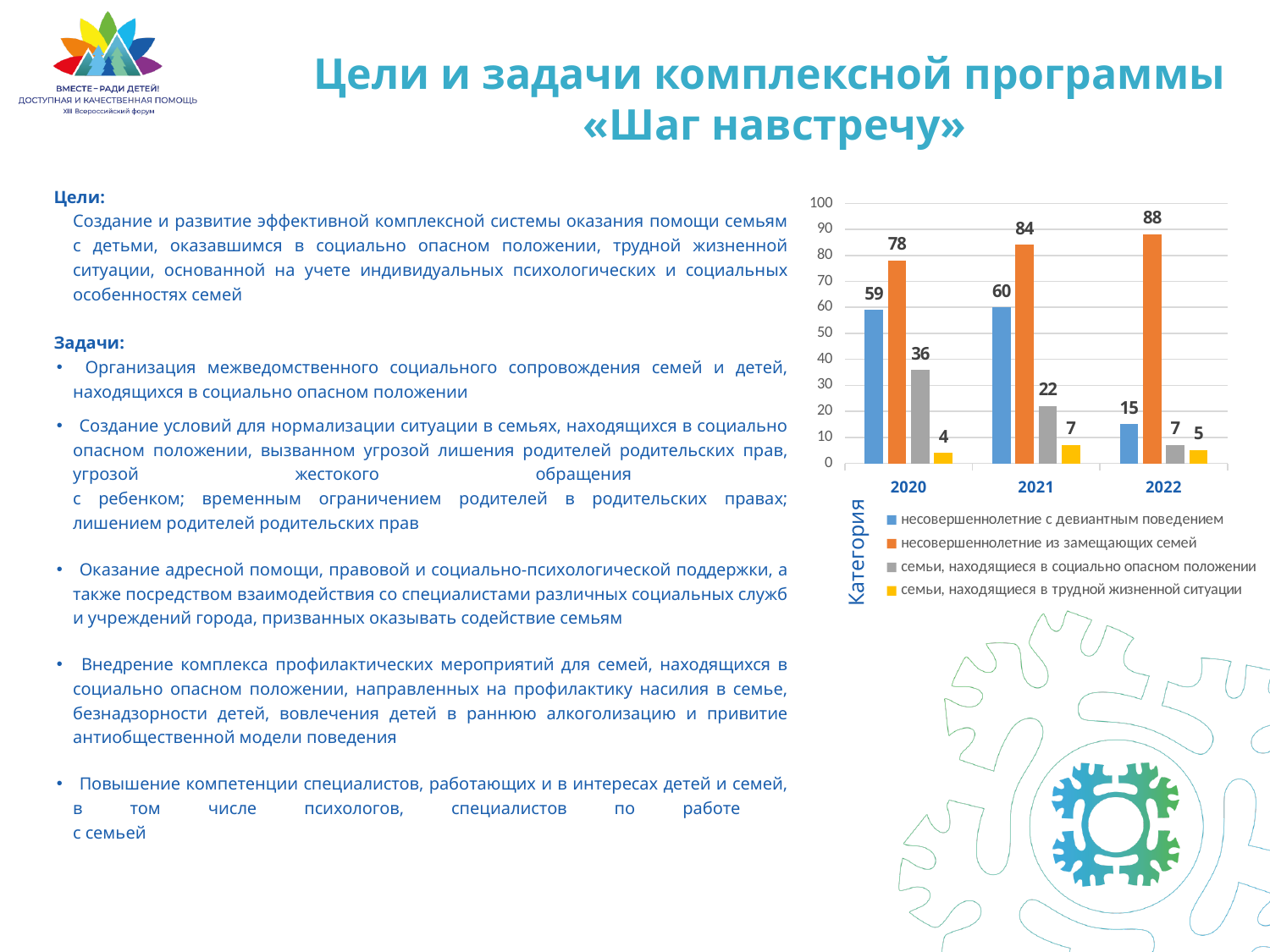
In which year is the value for «несовершеннолетние из замещающих семей» highest? 2022 How many series does the chart legend list? 4 What is the value for «несовершеннолетние с девиантным поведением» in 2022? 15 What is the value for «семьи, находящиеся в социально опасном положении» in 2020? 36 How many year categories are shown on the x axis of the chart? 3 How does the value for «семьи, находящиеся в социально опасном положении» change from 2020 to 2022? falls Which is larger: «несовершеннолетние с девиантным поведением» in 2020 or in 2021? 2021 What is the value for «несовершеннолетние из замещающих семей» in 2021? 84 What colour are the bars for «семьи, находящиеся в трудной жизненной ситуации»? yellow What is the difference between the values for «несовершеннолетние из замещающих семей» in 2022 and 2020? 10 In which year is the value for «семьи, находящиеся в социально опасном положении» lowest? 2022 What type of chart is shown on the slide? bar chart